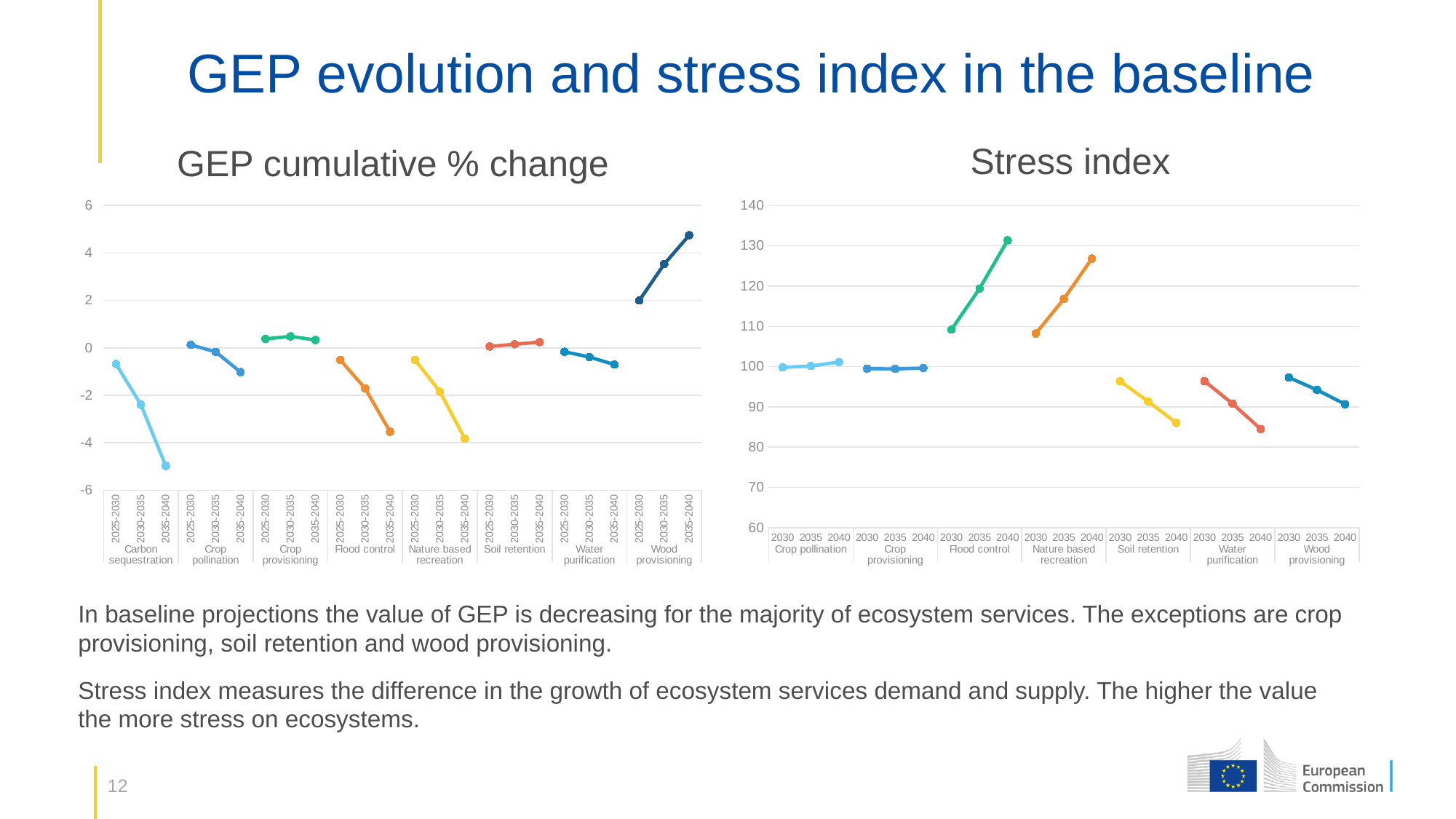
In the 'Stress index' chart, is the value for Nature based recreation in 2040 greater or less than 120? greater In the 'GEP cumulative % change' chart, which ecosystem service has the highest value in 2035-2040? Wood provisioning What kind of chart is the 'GEP cumulative % change' chart? Line chart In the 'Stress index' chart, do the values for Soil retention rise or fall from 2030 to 2040? Fall In the 'GEP cumulative % change' chart, how many ecosystem service categories are shown on the x axis? 8 In the 'GEP cumulative % change' chart, is the value for Wood provisioning in 2035-2040 greater or less than 4? greater In the 'Stress index' chart, which ecosystem service has the highest value in 2040? Flood control In the 'GEP cumulative % change' chart, do the values for Carbon sequestration rise or fall from 2025-2030 to 2035-2040? Fall In the 'GEP cumulative % change' chart, is the value for Carbon sequestration in 2035-2040 greater or less than -4? less In the 'Stress index' chart, how many ecosystem service categories are shown on the x axis? 7 In the 'GEP cumulative % change' chart, do the values for Wood provisioning rise or fall from 2025-2030 to 2035-2040? Rise In the 'GEP cumulative % change' chart, which ecosystem service has the lowest value in 2035-2040? Carbon sequestration